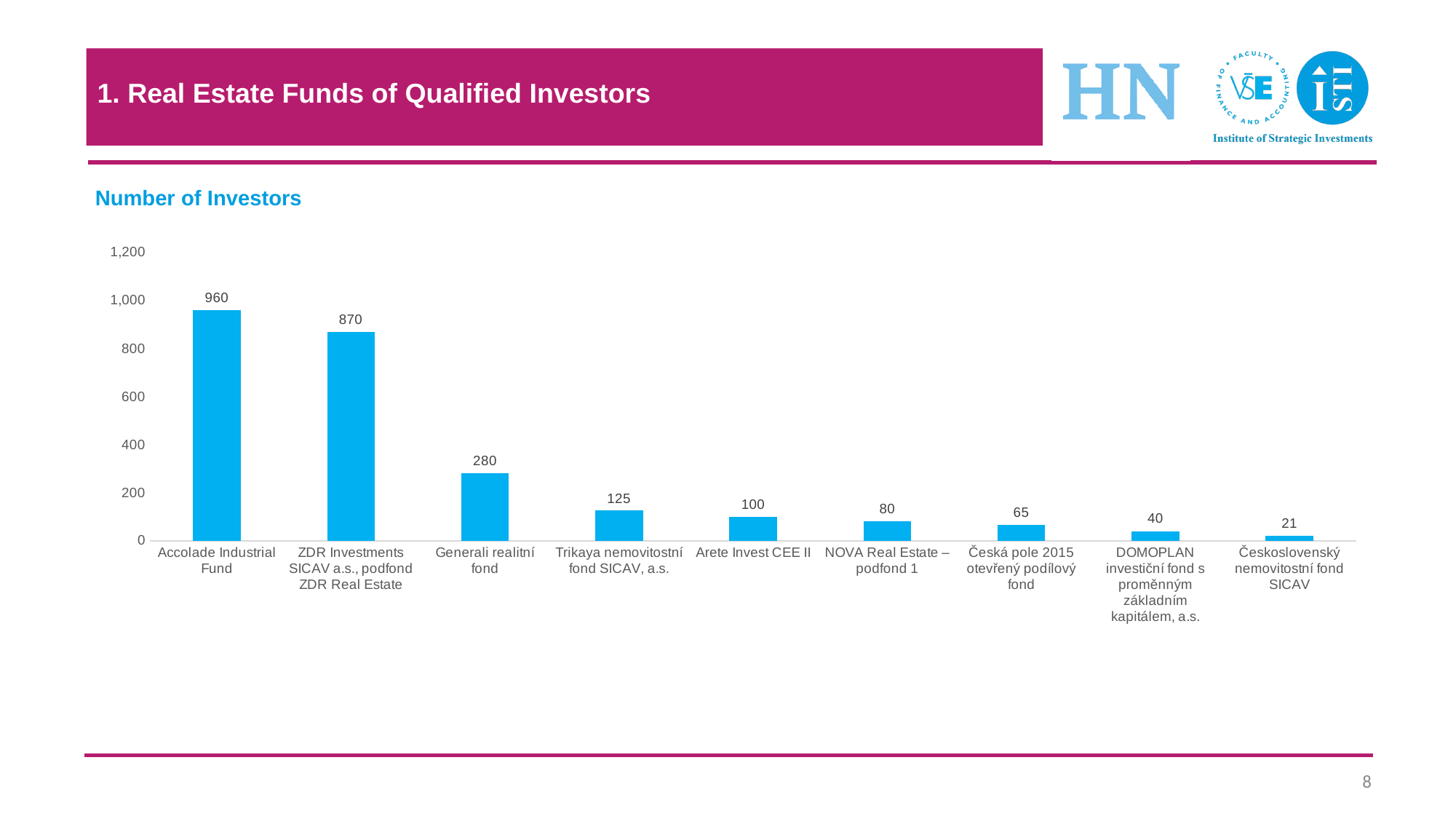
What is the number of investors for Accolade Industrial Fund? 960 What is the number of investors for Arete Invest CEE II? 100 What kind of chart is shown on the slide? bar chart Is the number of investors for Česká pole 2015 otevřený podílový fond greater or less than 200? less How many funds are shown in the chart? 9 Which fund has the lowest number of investors? Československý nemovitostní fond SICAV What is the number of investors for Generali realitní fond? 280 What is the title of the chart? Number of Investors What is the number of investors for Československý nemovitostní fond SICAV? 21 Which has more investors, Trikaya nemovitostní fond SICAV, a.s. or NOVA Real Estate – podfond 1? Trikaya nemovitostní fond SICAV, a.s. Which fund has the highest number of investors? Accolade Industrial Fund What is the difference in number of investors between Accolade Industrial Fund and ZDR Investments SICAV a.s., podfond ZDR Real Estate? 90